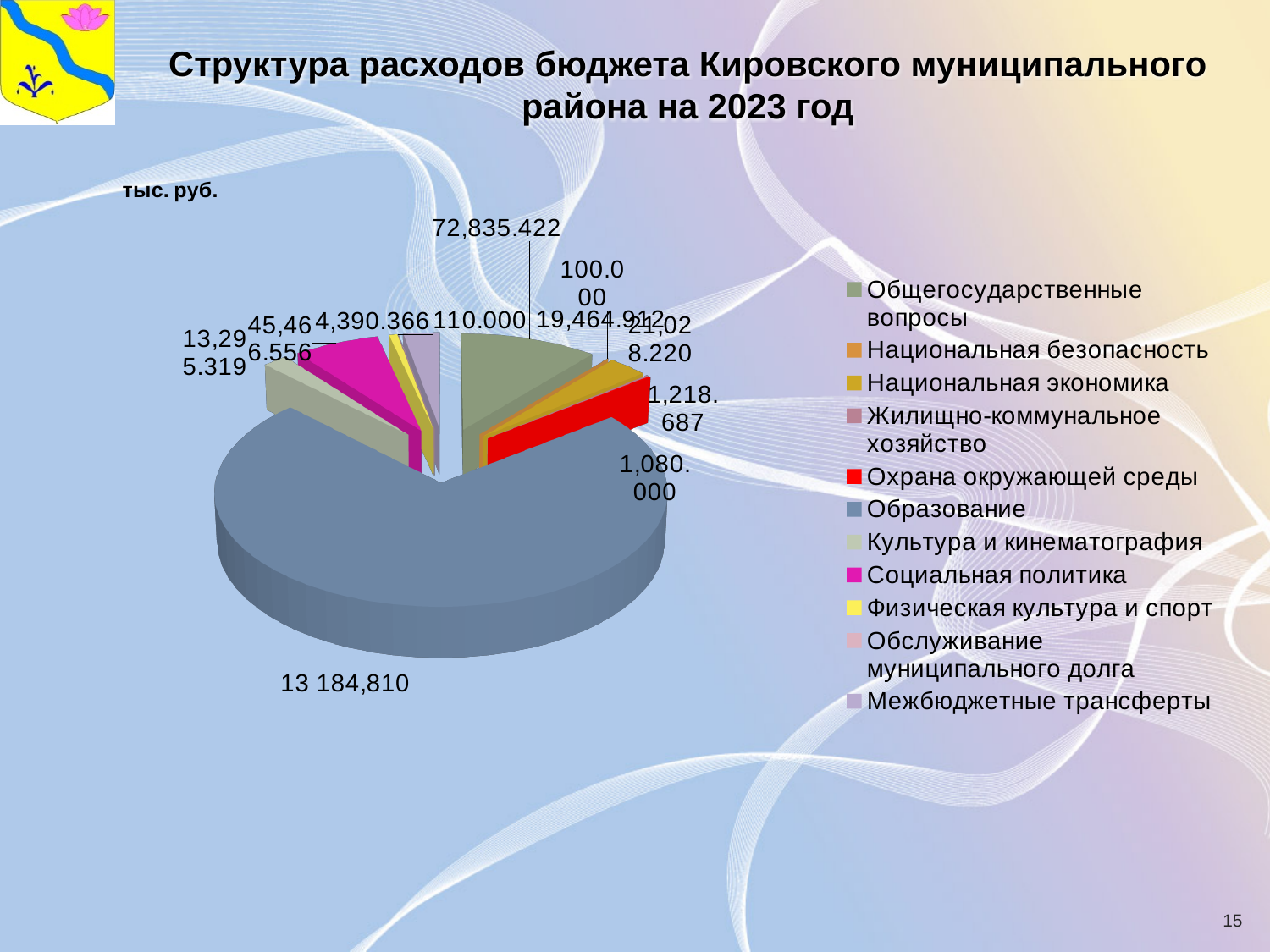
What is the value shown for Физическая культура и спорт? 4,390.366 Which category is shown in red in the legend? Охрана окружающей среды What is the value shown for Культура и кинематография? 13,295.319 What kind of chart is shown on the slide? pie chart What unit is stated for the values in the chart? тыс. руб. What is the value shown for Социальная политика? 45,466.556 How many categories does the legend of the pie chart list? 11 What is the value shown for Национальная экономика? 21,028.220 What is the value shown for Общегосударственные вопросы? 72,835.422 Which is larger, the slice for Образование or the slice for Общегосударственные вопросы? Образование Which is larger, the slice for Общегосударственные вопросы or the slice for Социальная политика? Общегосударственные вопросы Which category has the largest slice of the pie chart? Образование